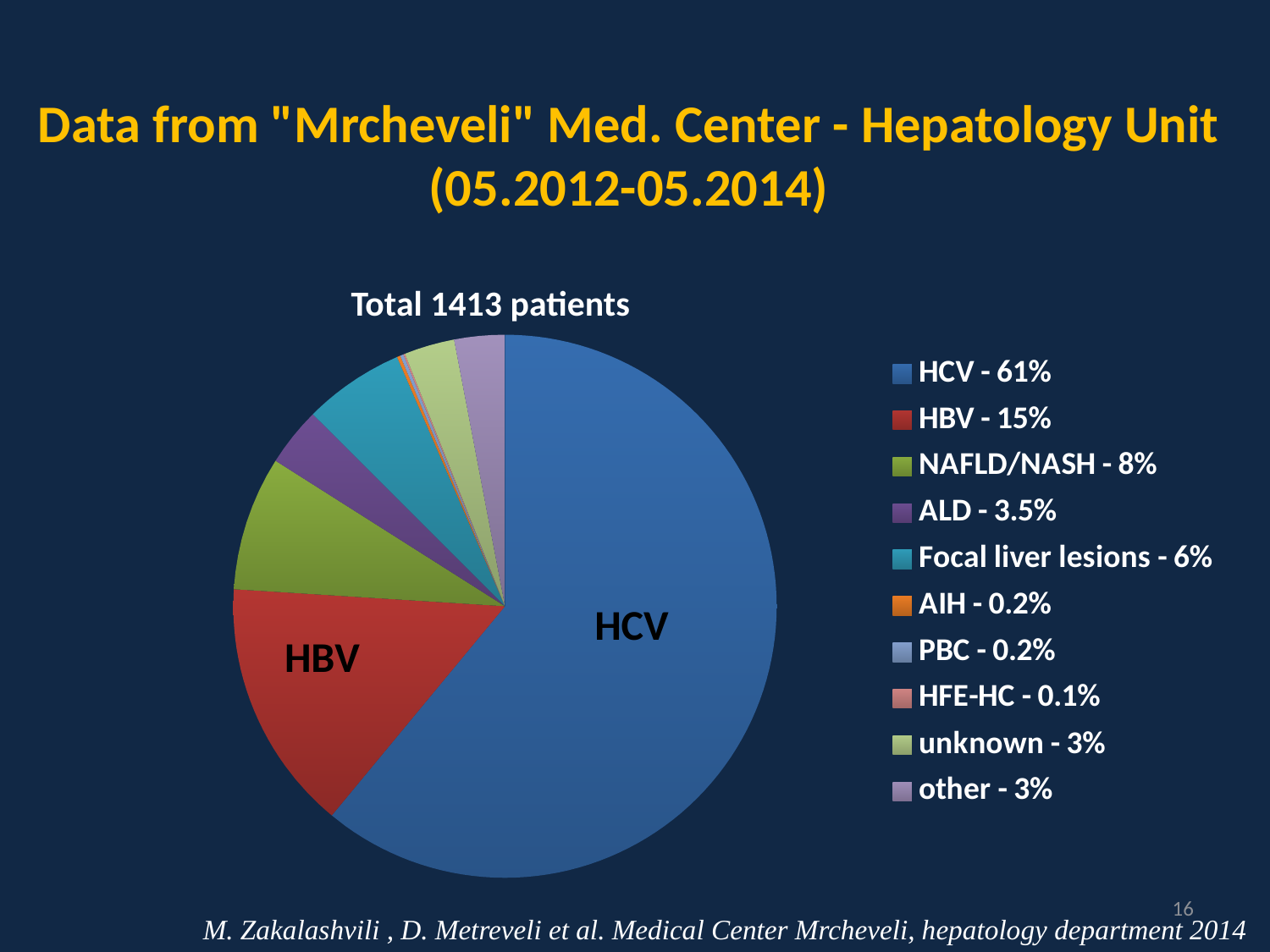
What percentage is shown for ALD? 3.5% What share of patients does HBV account for? 15% What kind of chart is shown on the slide? pie chart What is the difference in percentage points between HCV and HBV? 46 Which category has the largest share of the pie? HCV What share of patients does HCV account for? 61% What percentage is shown for Focal liver lesions? 6% Which is larger, the share for NAFLD/NASH or the share for Focal liver lesions? NAFLD/NASH What percentage is shown for NAFLD/NASH? 8% Which category has the smallest share of the pie? HFE-HC How many entries does the legend list? 10 What is the chart's title? Total 1413 patients